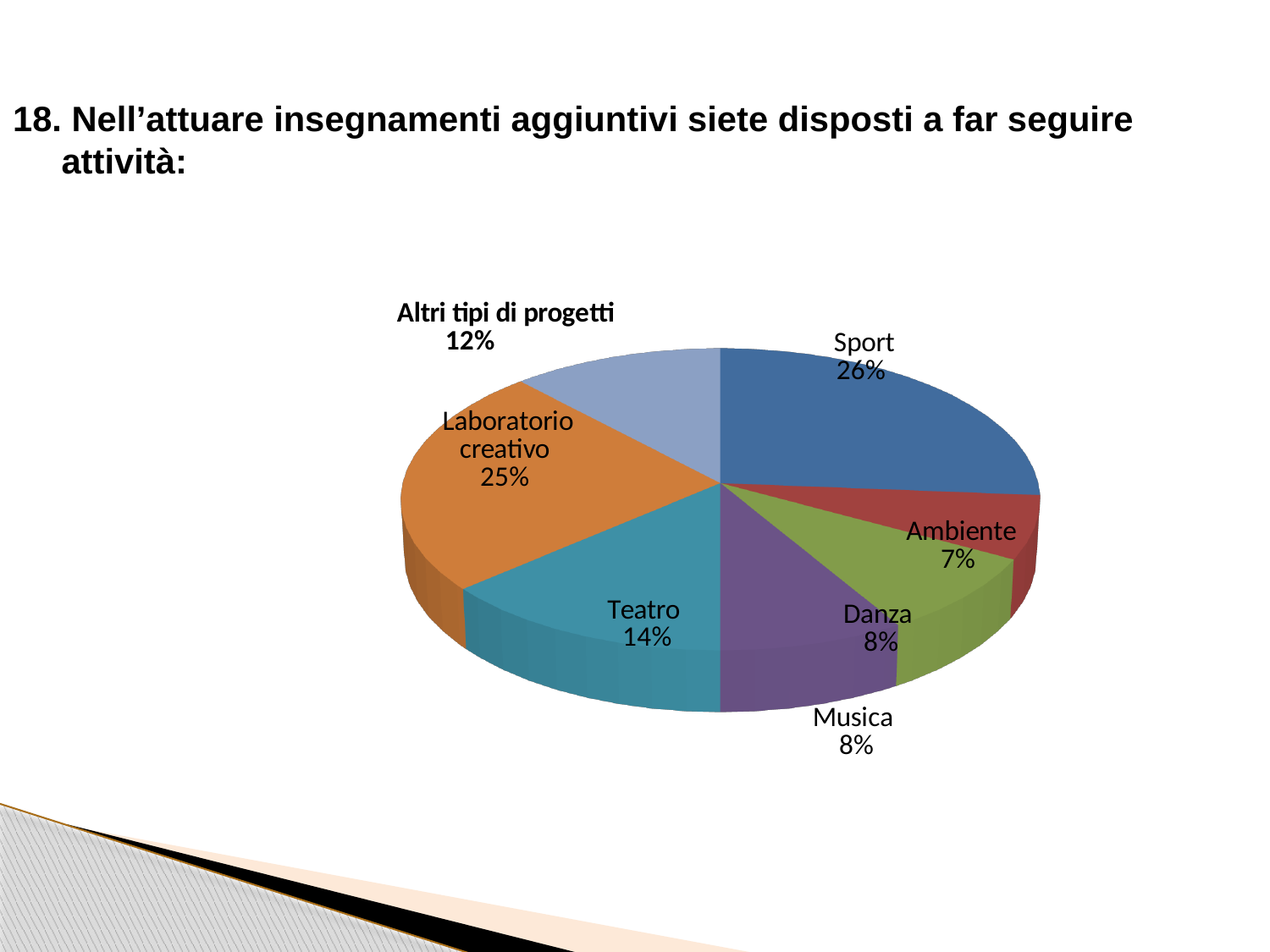
How many categories are shown in the pie chart? 7 Which category has the largest slice of the pie? Sport What percentage is shown for Teatro? 14% What is the value for Altri tipi di progetti? 12% What is the combined share of Danza and Musica? 16% Which category has the smallest slice of the pie? Ambiente What is the difference between the Sport and Teatro percentages? 12% What kind of chart is shown on the slide? Pie chart Which is larger, Laboratorio creativo or Altri tipi di progetti? Laboratorio creativo What share of the pie does Sport represent? 26% What colour is the Sport slice? Blue What is the value shown for Laboratorio creativo? 25%